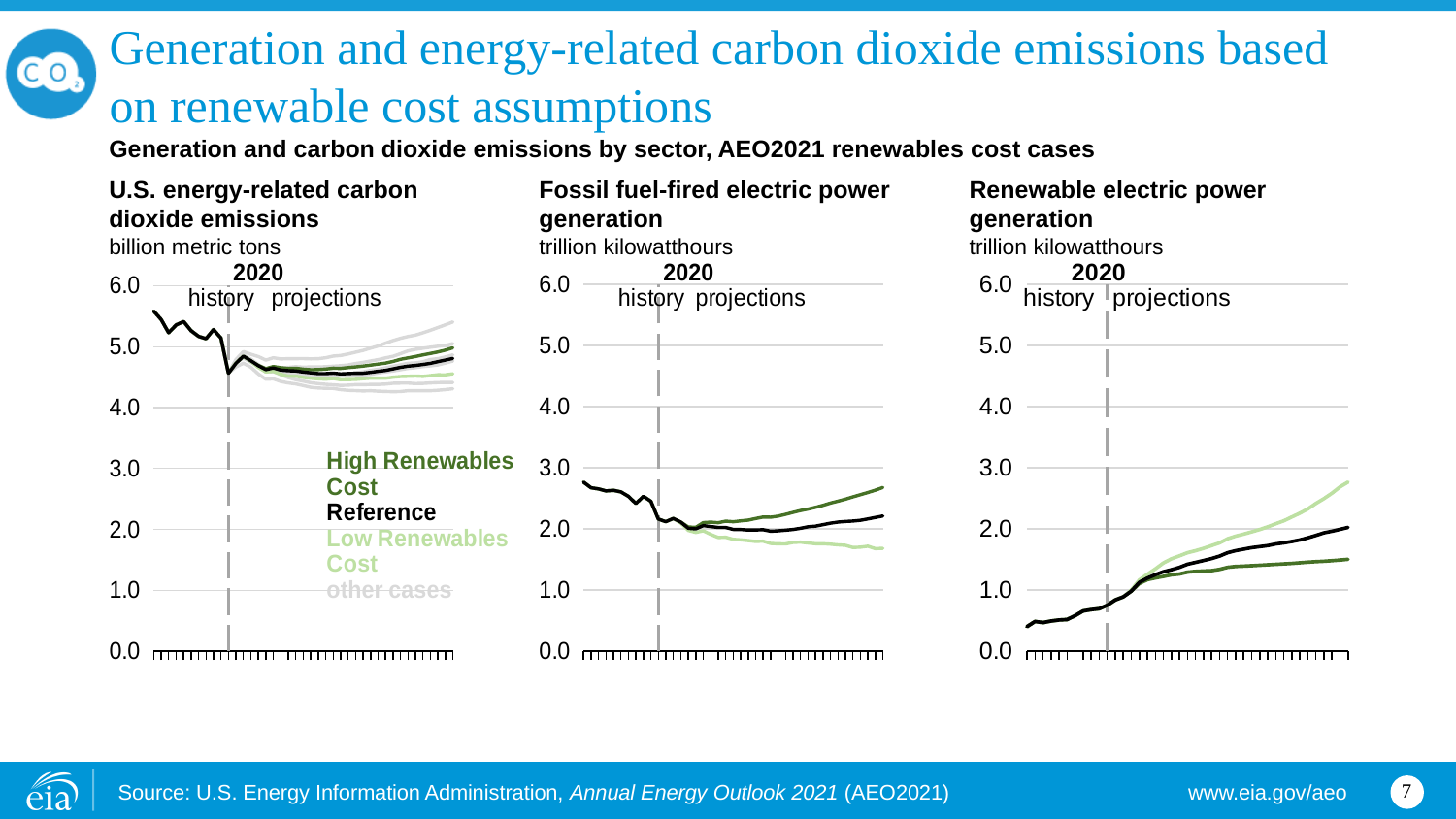
In the Fossil fuel-fired electric power generation chart, is the value for the High Renewables Cost case at the end of the projection period greater or less than 2.0? greater How many charts are shown on the slide? 3 In the Fossil fuel-fired electric power generation chart, is the value for the Low Renewables Cost case at the end of the projection period greater or less than 2.0? less What unit is used on the Fossil fuel-fired electric power generation chart? trillion kilowatthours In the Renewable electric power generation chart, which case is higher at the end of the projection period, High Renewables Cost or Low Renewables Cost? Low Renewables Cost Which year does the dashed vertical line separating history from projections mark on the charts? 2020 In the Renewable electric power generation chart, do the values rise or fall over the projection period? rise What kind of chart is the U.S. energy-related carbon dioxide emissions chart? line chart In the Fossil fuel-fired electric power generation chart, does the Low Renewables Cost line rise or fall over the projection period? fall How many cases does the legend on the U.S. energy-related carbon dioxide emissions chart list? 4 In the Renewable electric power generation chart, is the value at the start of the history period greater or less than 1.0? less